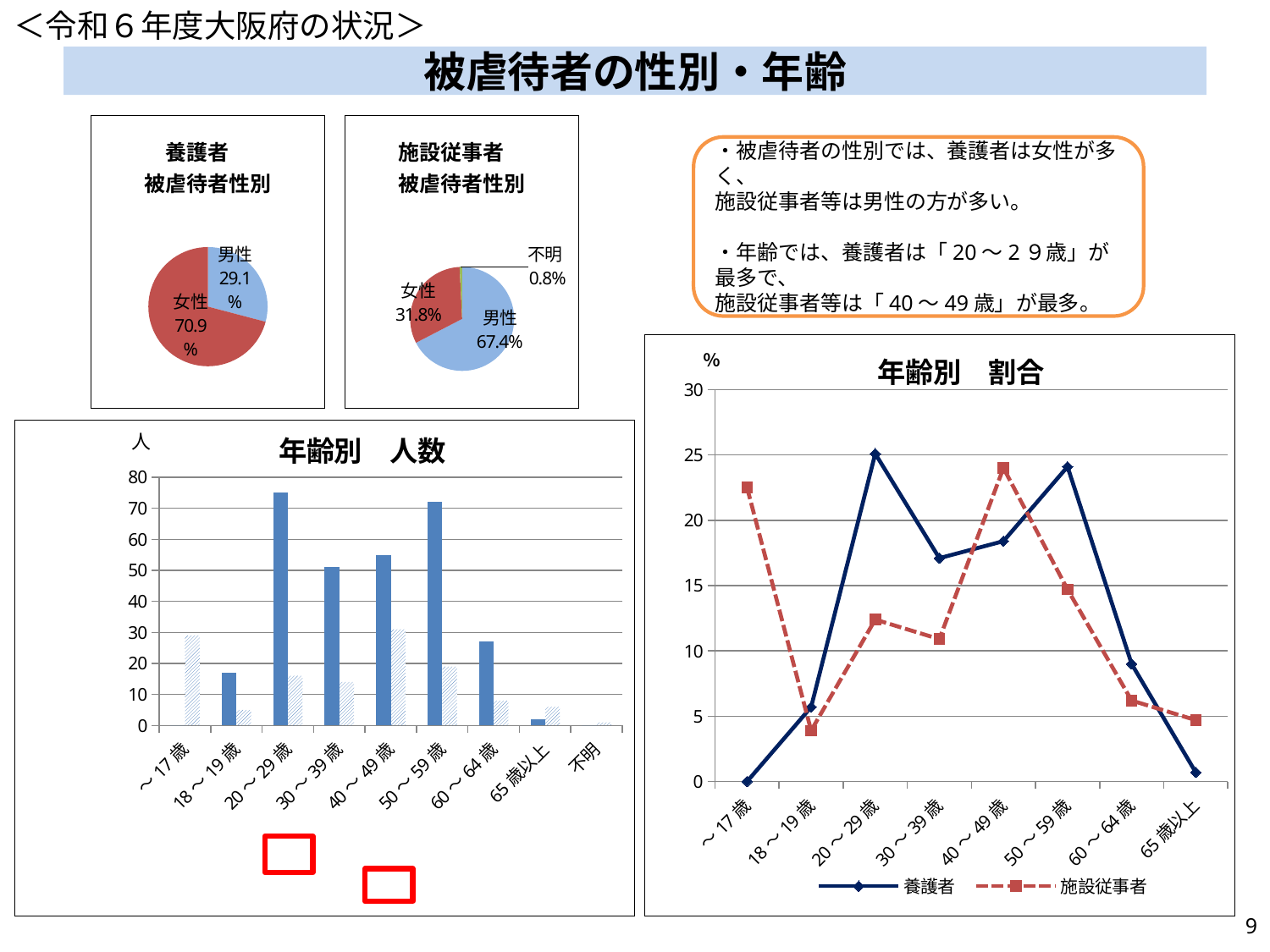
In the 年齢別 人数 chart, is the solid blue bar for 18～19歳 greater or less than 20? less How many series does the legend of the 年齢別 割合 chart list? 2 What kind of chart is the 年齢別 人数 chart? bar chart In the 施設従事者 被虐待者性別 pie chart, what percentage is 不明? 0.8% In the 年齢別 割合 chart, is the 養護者 value for ～17歳 greater or less than 5? less In the 年齢別 割合 chart, which age category has the highest value for 養護者? 20～29歳 In the 施設従事者 被虐待者性別 pie chart, what percentage is 男性? 67.4% How many age categories are shown on the x axis of the 年齢別 人数 chart? 9 In the 養護者 被虐待者性別 pie chart, which slice is larger, 男性 or 女性? 女性 In the 年齢別 人数 chart, is the solid blue bar for 20～29歳 greater or less than 70? greater In the 年齢別 割合 chart, which age category has the highest value for 施設従事者? 40～49歳 In the 養護者 被虐待者性別 pie chart, what percentage is 女性? 70.9%